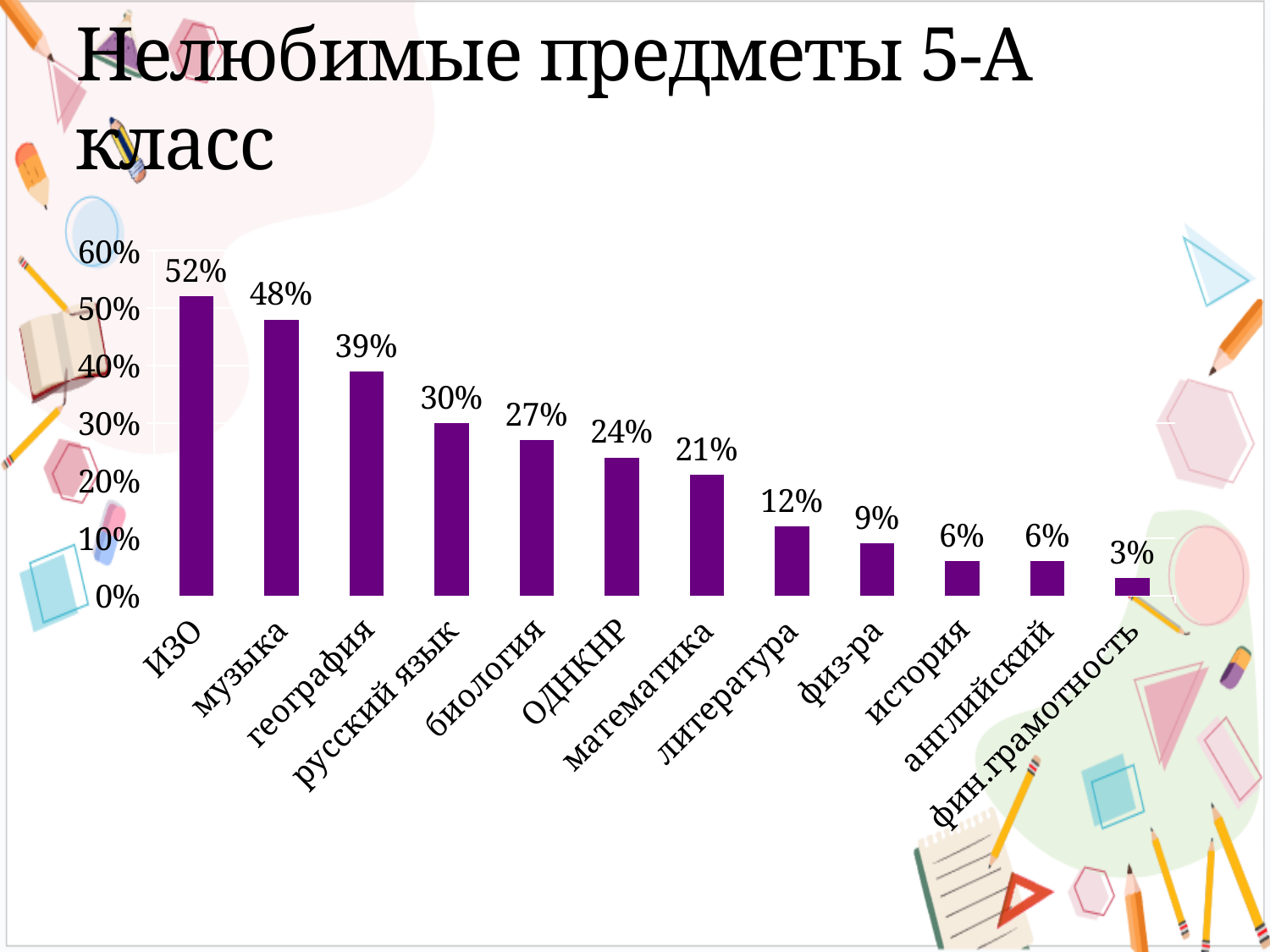
What kind of chart is shown on the slide? bar chart What is the value for литература? 12% What is the value for биология? 27% Which category has the highest value? ИЗО Which is larger, the value for русский язык or the value for математика? русский язык Which category has the lowest value? фин.грамотность Is the value for ОДНКНР greater or less than 20%? greater Do the values rise or fall from left to right along the x axis? fall What is the difference between the values for ИЗО and география? 13% How many categories are shown on the x axis? 12 What is the title of the slide? Нелюбимые предметы 5-А класс What is the value for музыка? 48%